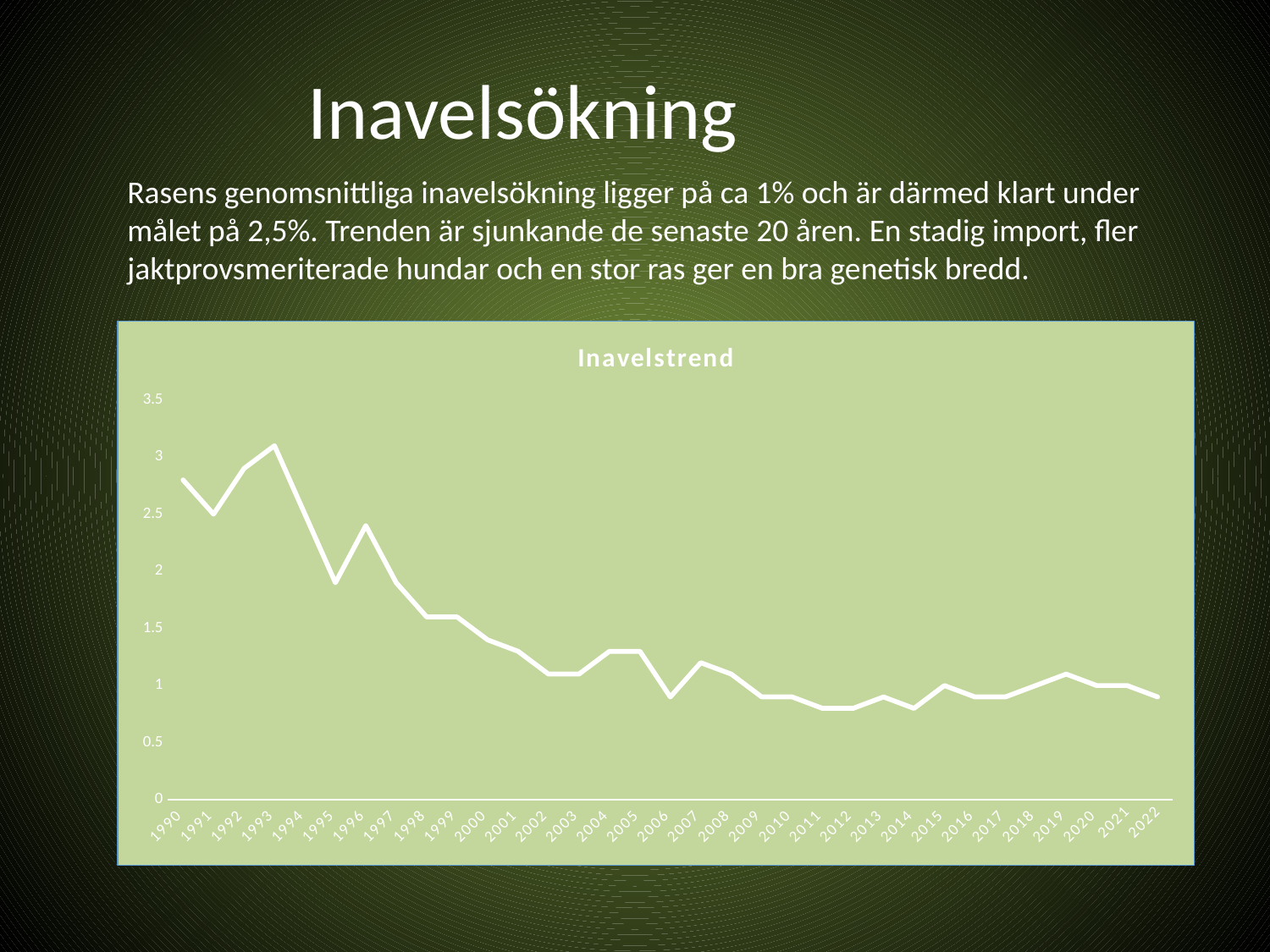
Is the value for 1998 greater or less than 1.5? greater What is the title of the chart? Inavelstrend Which year has the larger value, 2005 or 2006? 2005 Which year has the highest value in the chart? 1993 What kind of chart is shown on the slide? line chart How many years are plotted along the x axis of the chart? 33 Is the value for 2022 greater or less than 1? less Is the value for 1993 greater or less than 3? greater Do the values generally rise or fall from 1990 to 2022? fall Which year has the larger value, 1990 or 2022? 1990